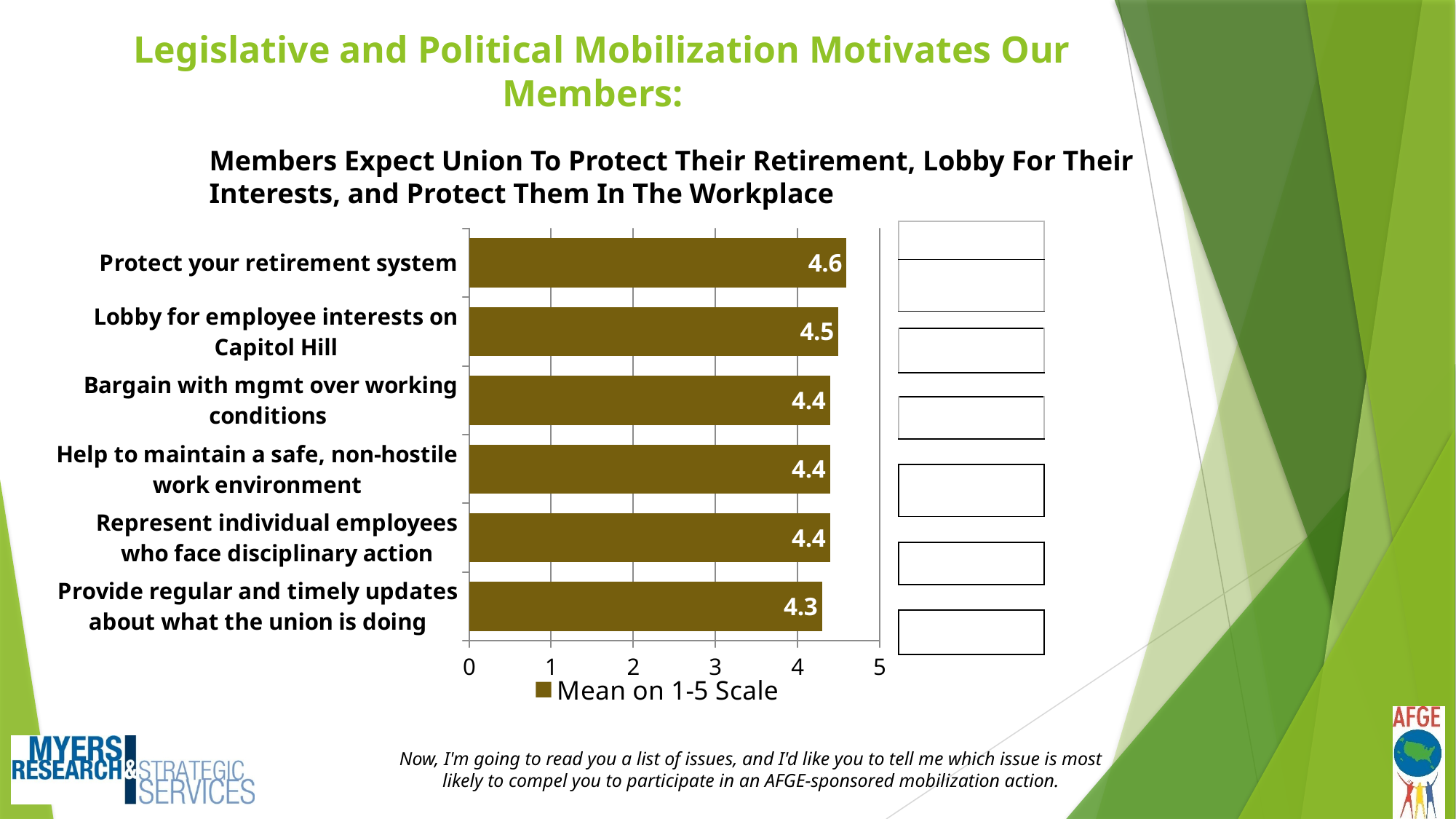
What is the legend entry for the series in the chart? Mean on 1-5 Scale What is the mean score for "Lobby for employee interests on Capitol Hill"? 4.5 Which has a higher mean score: "Lobby for employee interests on Capitol Hill" or "Provide regular and timely updates about what the union is doing"? Lobby for employee interests on Capitol Hill Is the value for "Protect your retirement system" greater or less than 4? greater What is the difference between the mean scores for "Protect your retirement system" and "Provide regular and timely updates about what the union is doing"? 0.3 What is the mean score for "Protect your retirement system"? 4.6 What kind of chart is shown on the slide? Bar chart Which category has the highest mean score? Protect your retirement system What is the mean score for "Bargain with mgmt over working conditions"? 4.4 What is the mean score for "Provide regular and timely updates about what the union is doing"? 4.3 Which category has the lowest mean score? Provide regular and timely updates about what the union is doing How many categories are shown in the chart? 6